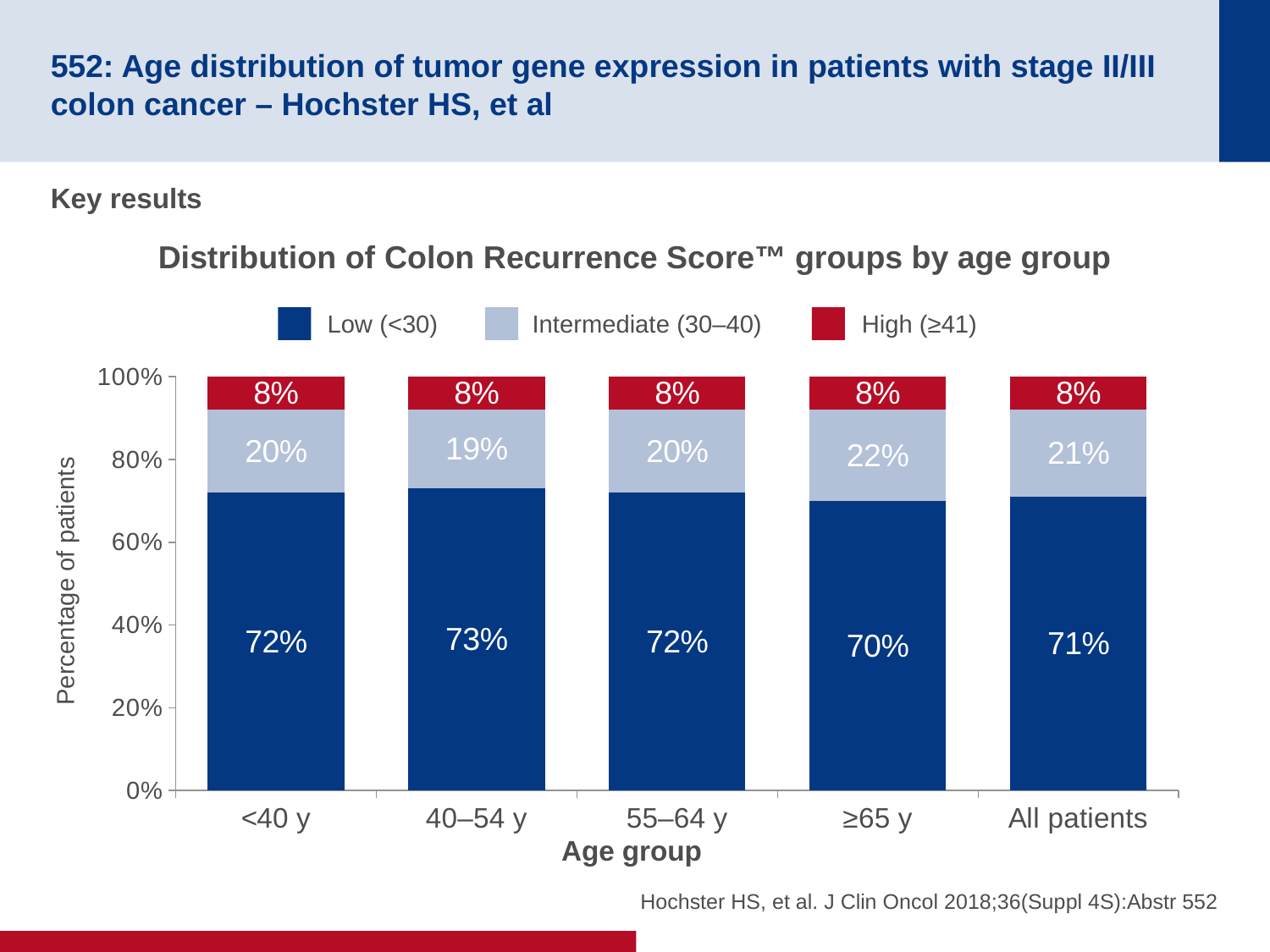
Which is larger: the Intermediate (30–40) percentage for ≥65 y or for 40–54 y? ≥65 y How many age group categories are shown on the x axis? 5 How many series does the legend list? 3 Which age group has the lowest percentage in the Low (<30) group? ≥65 y What percentage of All patients are in the High (≥41) group? 8% Which age group has the highest percentage in the Low (<30) group? 40–54 y What is the title of the chart? Distribution of Colon Recurrence Score™ groups by age group What kind of chart is shown on the slide? Stacked bar chart What percentage of patients aged <40 y are in the Low (<30) group? 72% What is the difference between the Low (<30) percentage for 40–54 y and for ≥65 y? 3% What percentage of patients aged ≥65 y are in the Intermediate (30–40) group? 22% What percentage of patients aged 40–54 y are in the Low (<30) group? 73%